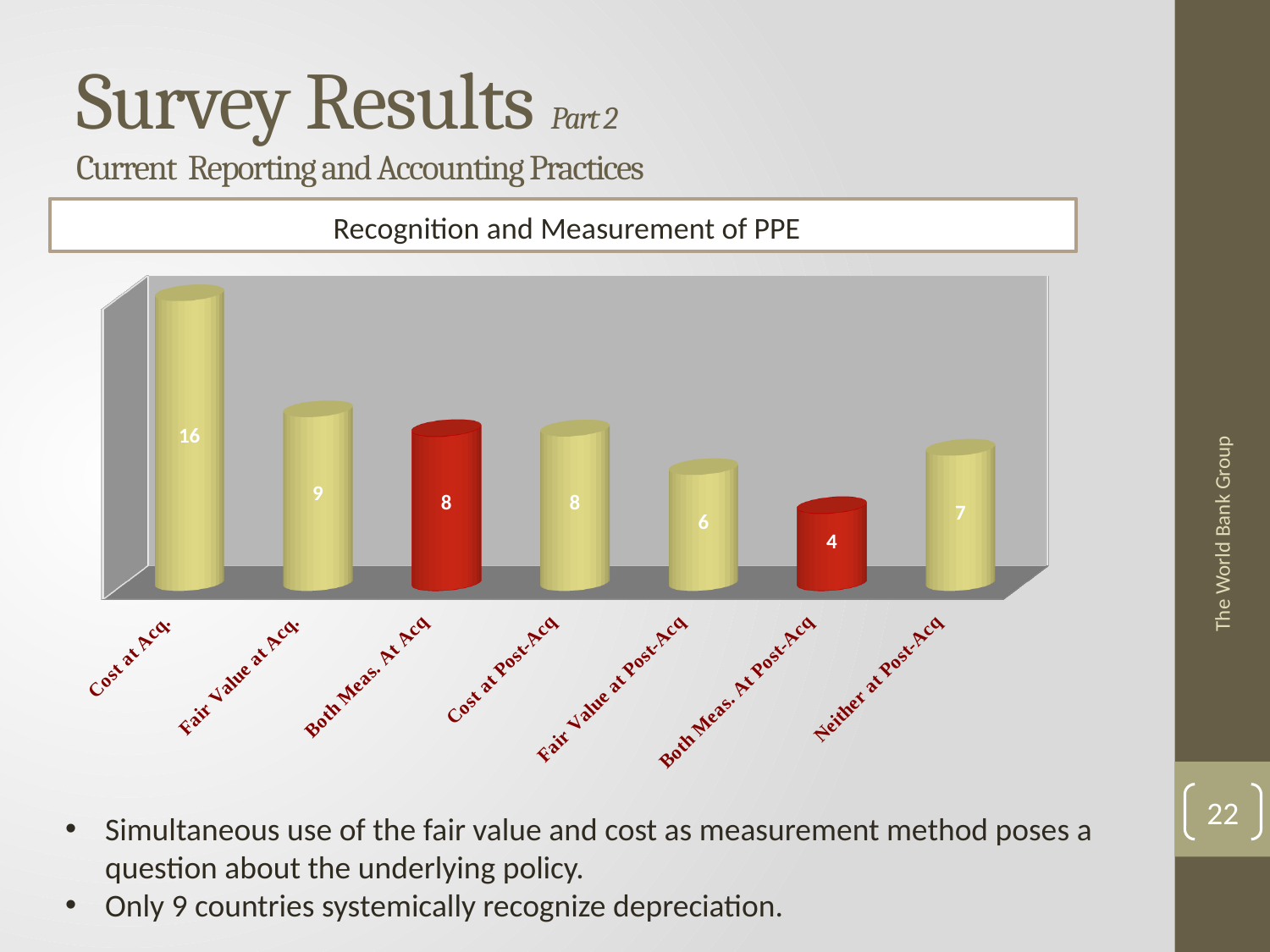
What kind of chart is shown on the slide? bar chart Which two categories are shown with red bars? Both Meas. At Acq and Both Meas. At Post-Acq What is the value for Cost at Acq.? 16 What is the value for Neither at Post-Acq? 7 What is the value for Both Meas. At Post-Acq? 4 What is the value for Fair Value at Post-Acq? 6 Which category has the highest value? Cost at Acq. How many categories are shown in the chart? 7 Which is larger, the value for Fair Value at Post-Acq or the value for Neither at Post-Acq? Neither at Post-Acq What is the difference between the values for Cost at Acq. and Fair Value at Acq.? 7 Which category has the lowest value? Both Meas. At Post-Acq What is the title shown above the chart? Recognition and Measurement of PPE